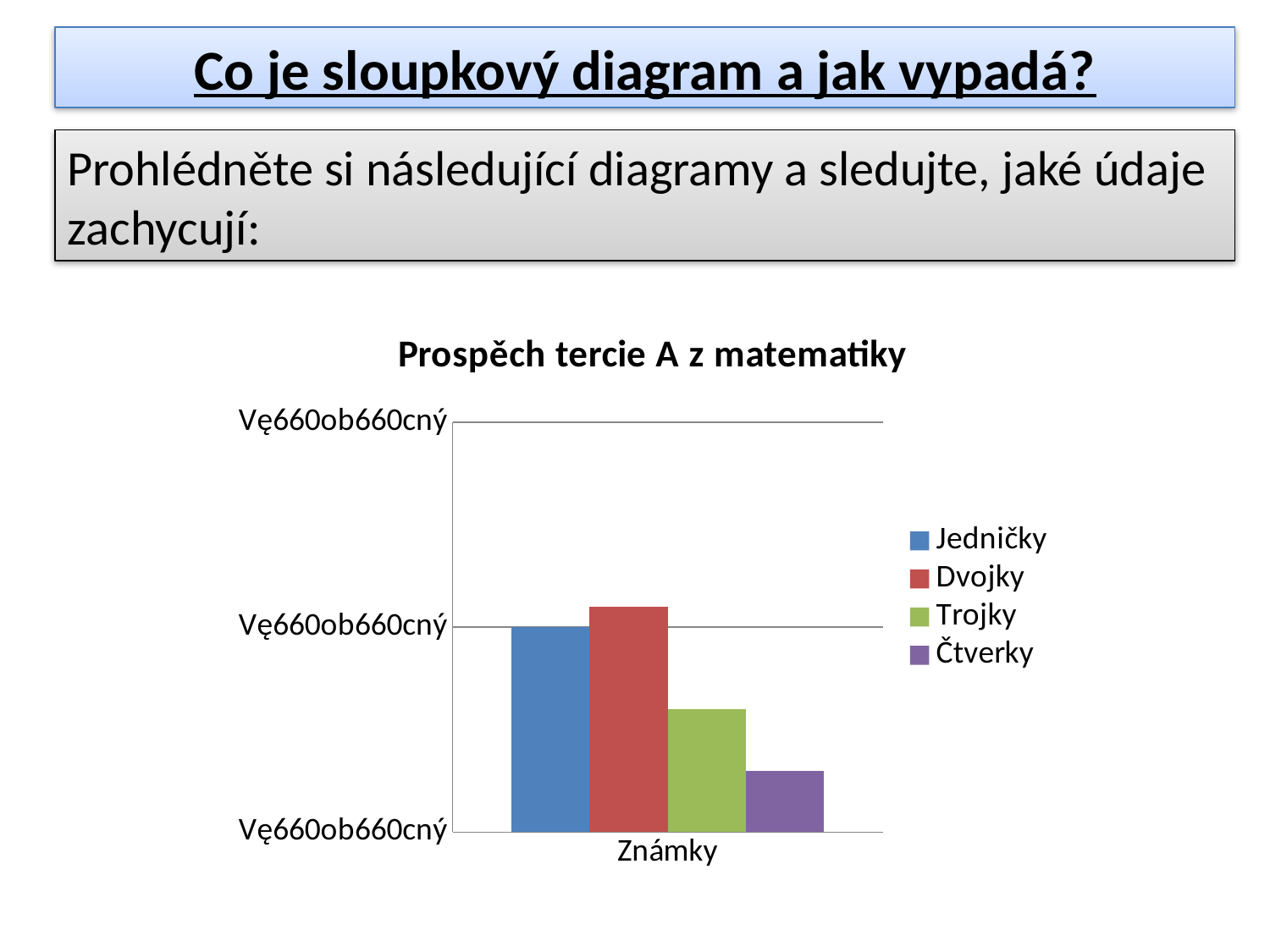
What kind of chart is shown on the slide? bar chart Which bar is taller, Jedničky or Trojky? Jedničky What is the title of the chart? Prospěch tercie A z matematiky Which bar is taller, Dvojky or Jedničky? Dvojky Which bar is taller, Trojky or Čtverky? Trojky Which series has the tallest bar in the chart? Dvojky What is the label shown on the horizontal axis of the chart? Známky How many bars are plotted in the chart? 4 How many series does the chart legend list? 4 Which series has the shortest bar in the chart? Čtverky